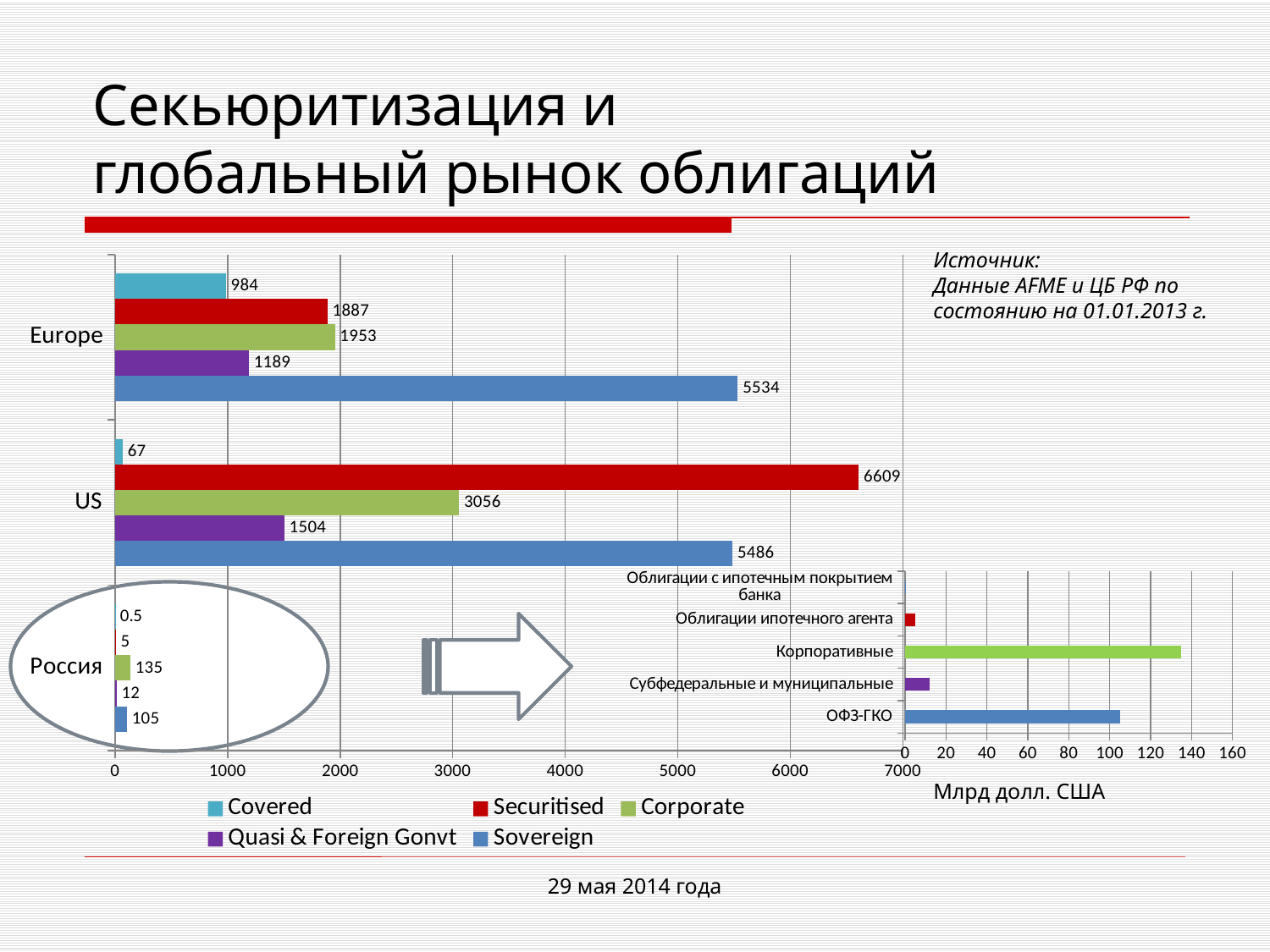
In the small chart on the right, is the value for Субфедеральные и муниципальные greater or less than 20? less How many series does the legend of the main bar chart on the left list? 5 In the main bar chart on the left, which series has the lowest value for US? Covered What unit label is shown under the x axis of the small chart on the right? Млрд долл. США In the small chart on the right, is the value for Корпоративные greater or less than 120? greater In the main bar chart on the left, which is larger for Europe: Corporate or Securitised? Corporate In the main bar chart on the left, what is the Sovereign value for Europe? 5534 In the main bar chart on the left, what is the Corporate value for Россия? 135 In the main bar chart on the left, what is the difference between the Sovereign values for Europe and US? 48 What kind of chart is the main chart on the left? Bar chart In the main bar chart on the left, which region has the highest Securitised value? US In the main bar chart on the left, what is the Securitised value for US? 6609